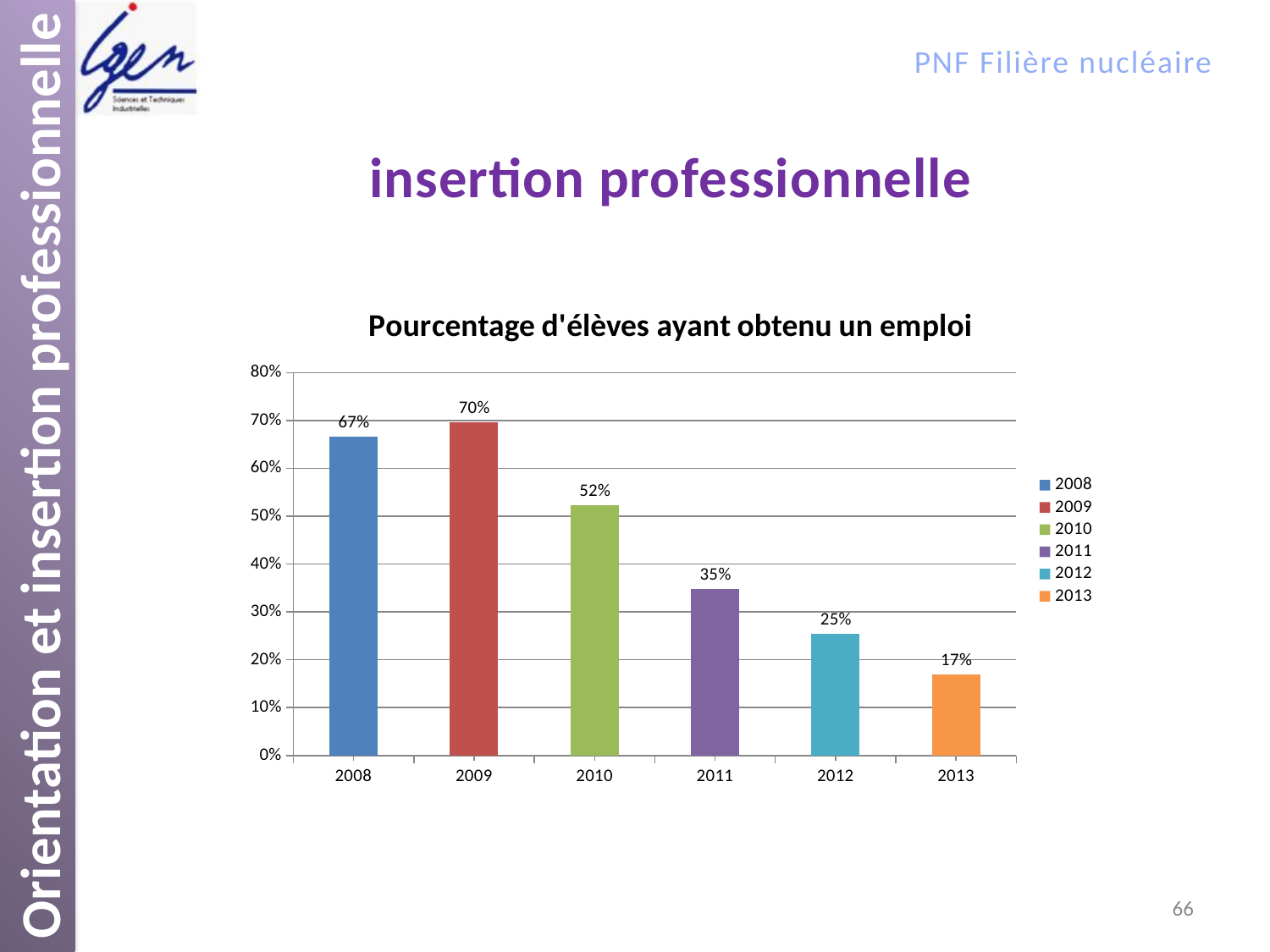
How many years are shown on the x axis? 6 Is the value for 2012 greater or less than 30%? less Do the values rise or fall from 2009 to 2013? fall What is the value for 2013? 17% What is the difference between the values for 2009 and 2013? 53% Which year has the highest percentage of students who obtained a job? 2009 What is the value for 2008? 67% What is the difference between the values for 2010 and 2011? 17% What kind of chart is shown on the slide? bar chart Which is larger, the value for 2010 or the value for 2012? 2010 Which year has the lowest percentage of students who obtained a job? 2013 What is the value for 2011? 35%